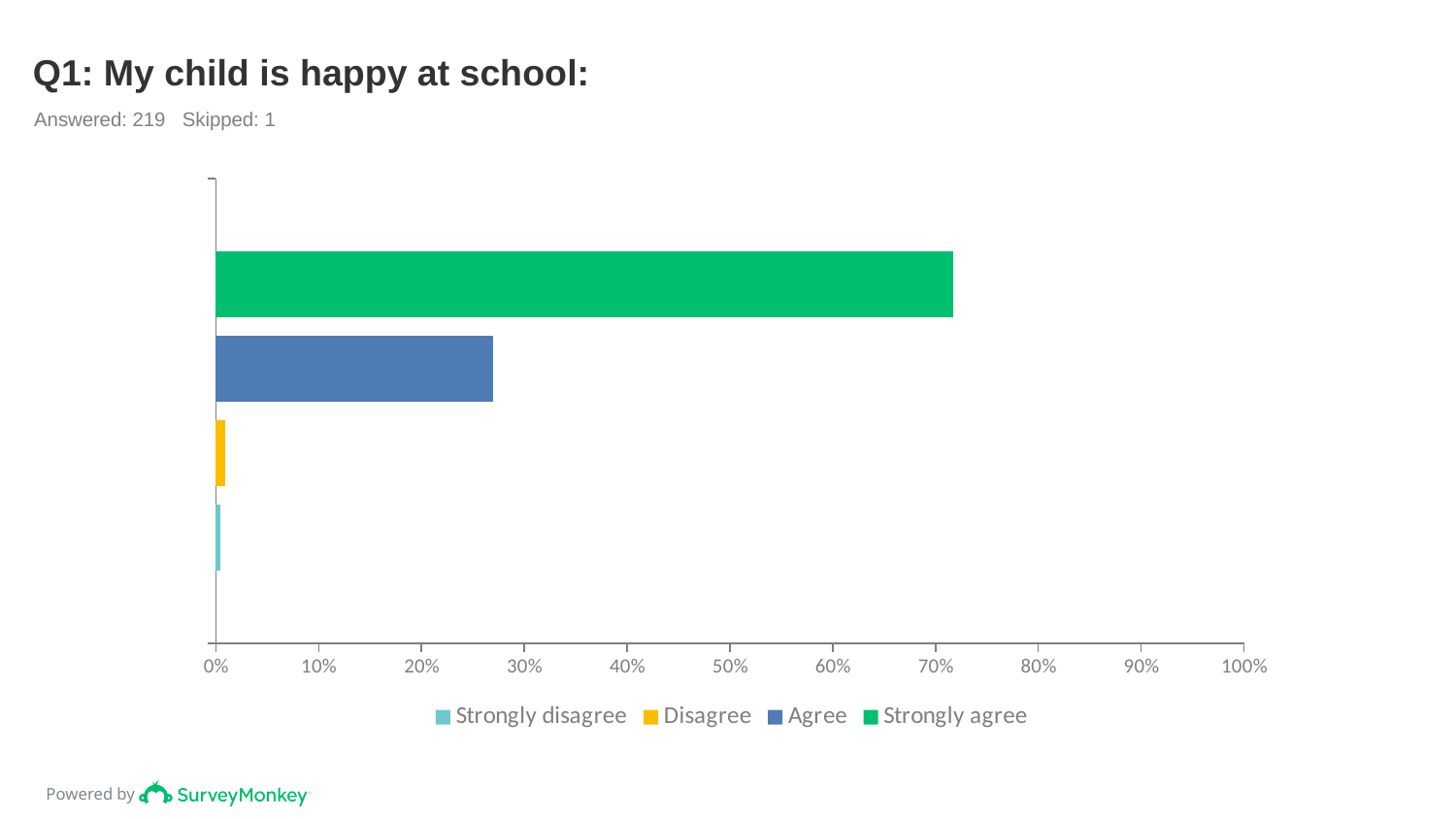
Is the value for Agree greater or less than 20%? greater Which response category has the lowest value? Strongly disagree Which response category has the highest value? Strongly agree Is the value for Strongly agree greater or less than 70%? greater Which is larger, the value for Strongly agree or the value for Agree? Strongly agree Is the value for Agree greater or less than 30%? less What kind of chart is shown on the slide? bar chart How many response categories does the legend list? 4 Which is larger, the value for Agree or the value for Disagree? Agree What is the title of the chart? Q1: My child is happy at school: How many respondents answered this question? 219